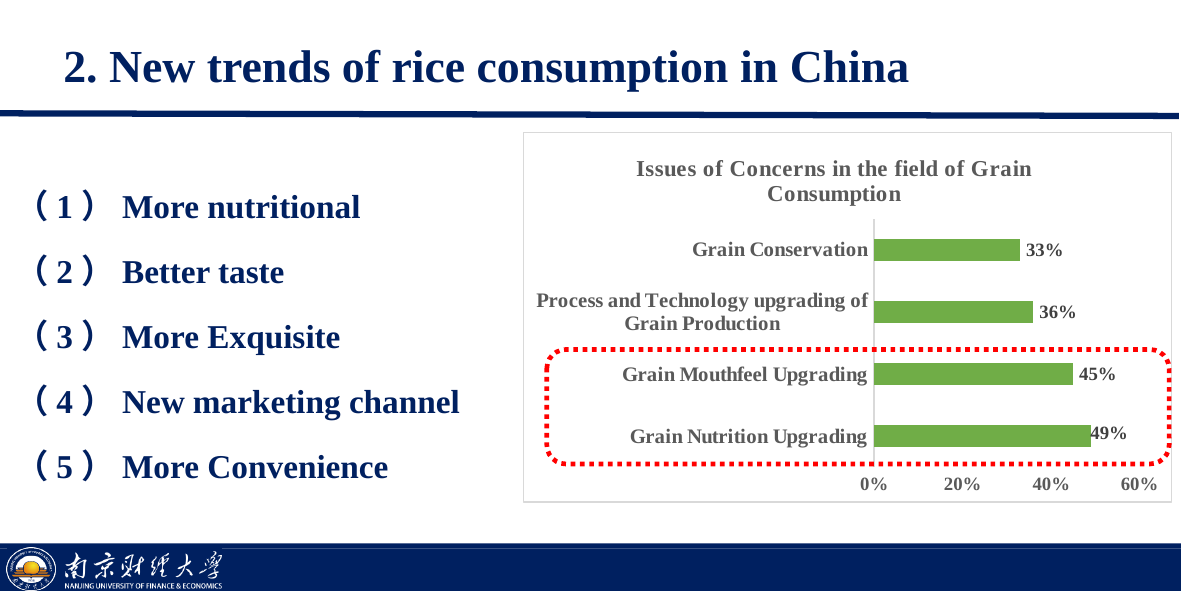
What is the highest value shown on the x axis of the chart? 60% Is the value for Grain Mouthfeel Upgrading greater or less than 40%? greater What is the title of the chart? Issues of Concerns in the field of Grain Consumption What is the value for Process and Technology upgrading of Grain Production? 36% Which is larger, the value for Grain Mouthfeel Upgrading or the value for Grain Conservation? Grain Mouthfeel Upgrading Which category has the highest value? Grain Nutrition Upgrading What is the value for Grain Conservation? 33% Which category has the lowest value? Grain Conservation What is the difference between the values for Grain Nutrition Upgrading and Grain Mouthfeel Upgrading? 4% What is the value for Grain Nutrition Upgrading? 49% How many categories are shown in the chart? 4 What kind of chart is shown on the slide? bar chart